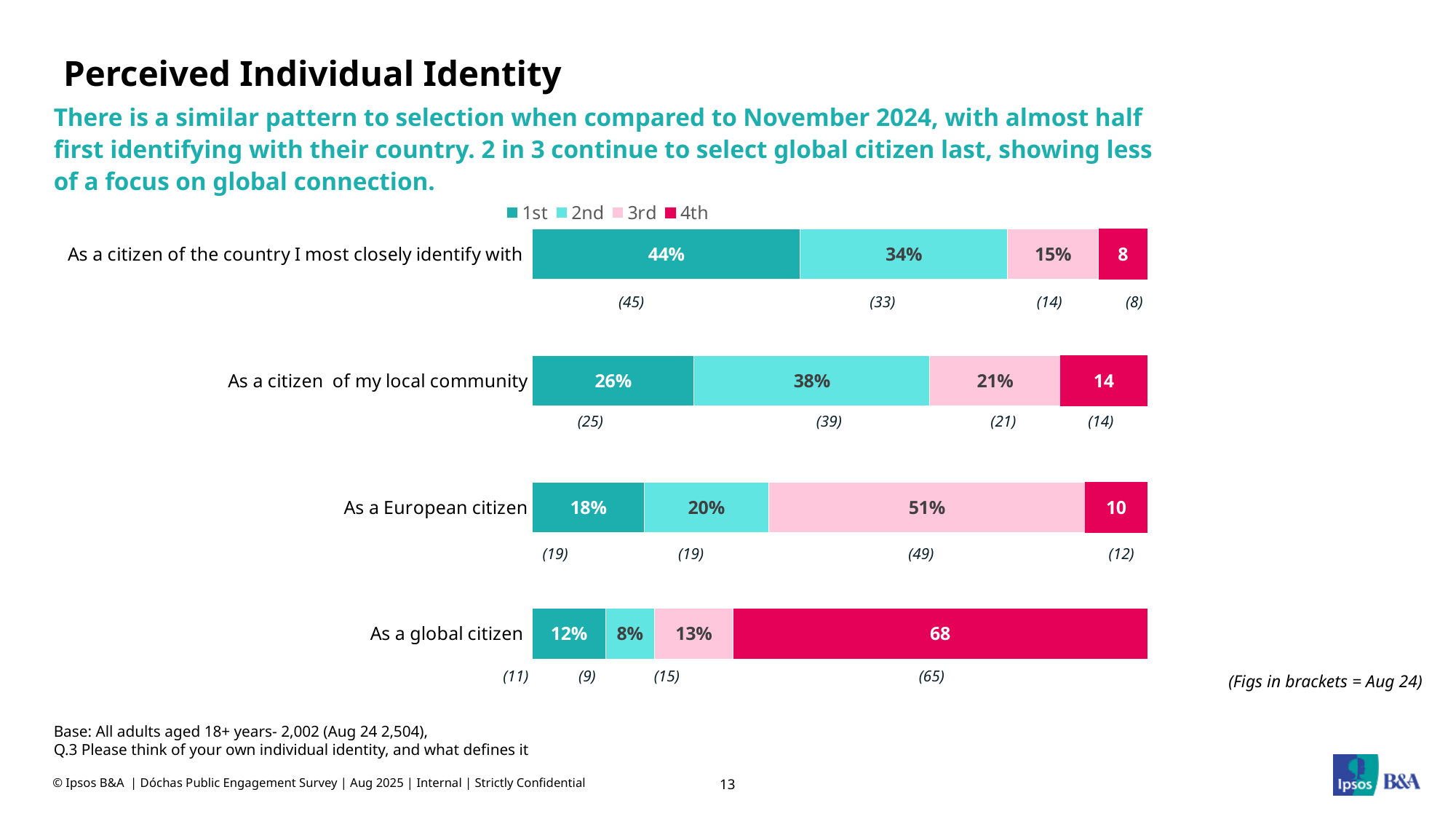
What is the value for the 3rd ranking of 'As a European citizen'? 51% What percentage ranked 'As a citizen of the country I most closely identify with' 1st? 44% Which category has the lowest 1st ranking value? As a global citizen What type of chart is shown on the slide? Stacked bar chart How many series does the legend list? 4 How many categories are shown in the chart? 4 Which category has the highest 1st ranking value? As a citizen of the country I most closely identify with What is the value shown for the 4th ranking of 'As a global citizen'? 68 What is the 2nd ranking value for 'As a citizen of my local community'? 38% Which is larger: the 2nd ranking value for 'As a European citizen' or the 2nd ranking value for 'As a global citizen'? As a European citizen What is the difference between the 1st ranking values for 'As a citizen of the country I most closely identify with' and 'As a citizen of my local community'? 18 percentage points What do the figures in brackets below the bars represent? Aug 24